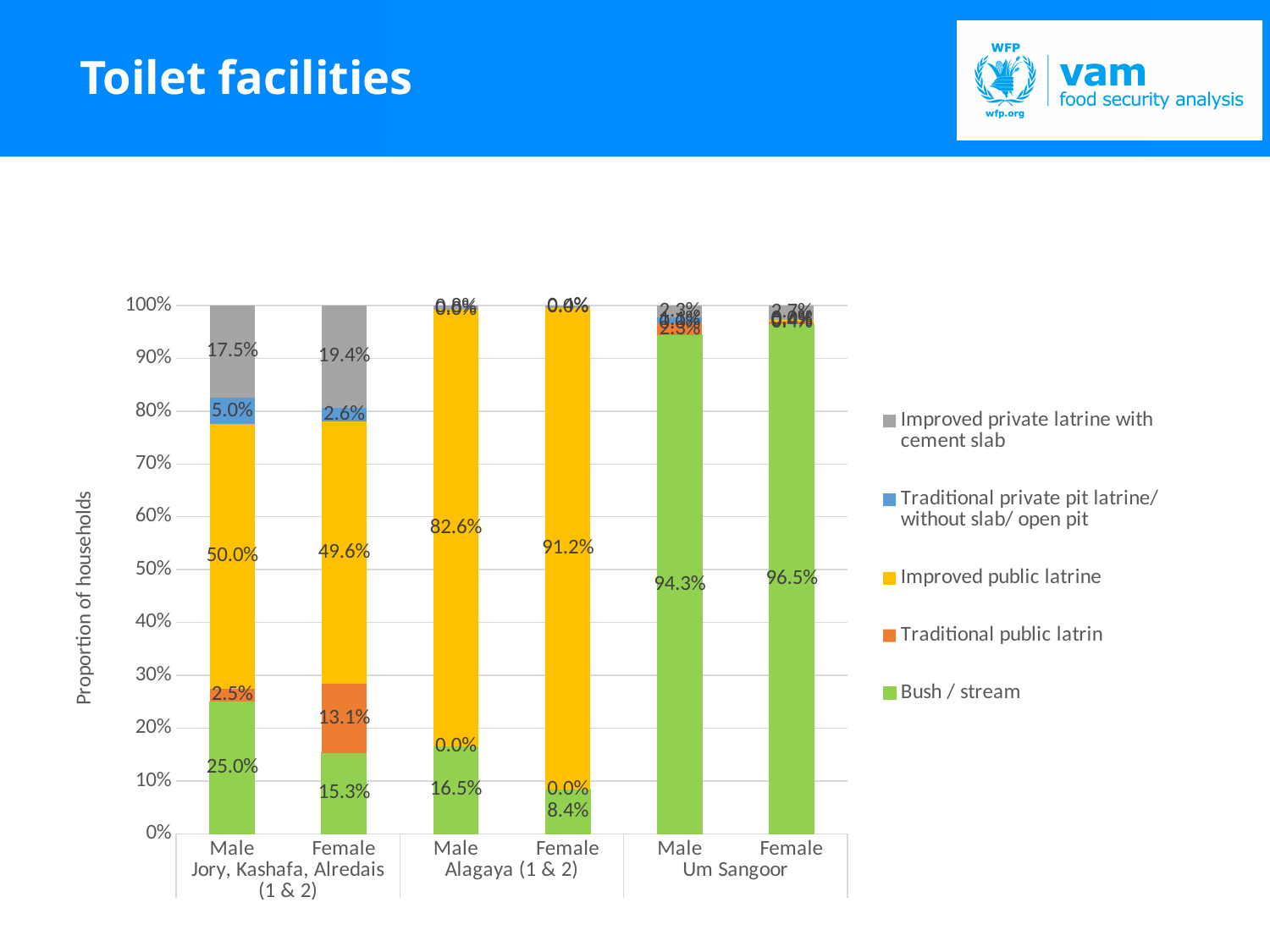
Which is larger: the Bush / stream share for Male households in Jory, Kashafa, Alredais (1 & 2) or for Male households in Alagaya (1 & 2)? Male, Jory, Kashafa, Alredais (1 & 2) Which bar has the highest Bush / stream share? Female, Um Sangoor What is the label of the vertical axis? Proportion of households How many series does the legend list? 5 What is the Traditional public latrin share for Female households in Jory, Kashafa, Alredais (1 & 2)? 13.1% How many bars are plotted in the chart? 6 What is the Improved private latrine with cement slab share for Female households in Jory, Kashafa, Alredais (1 & 2)? 19.4% What is the difference between the Improved public latrine shares for Male and Female households in Alagaya (1 & 2)? 8.6% What kind of chart is shown on the slide? Stacked bar chart What is the Bush / stream share for Male households in Um Sangoor? 94.3% Which bar has the lowest Bush / stream share? Female, Alagaya (1 & 2) What is the Improved public latrine share for Female households in Alagaya (1 & 2)? 91.2%